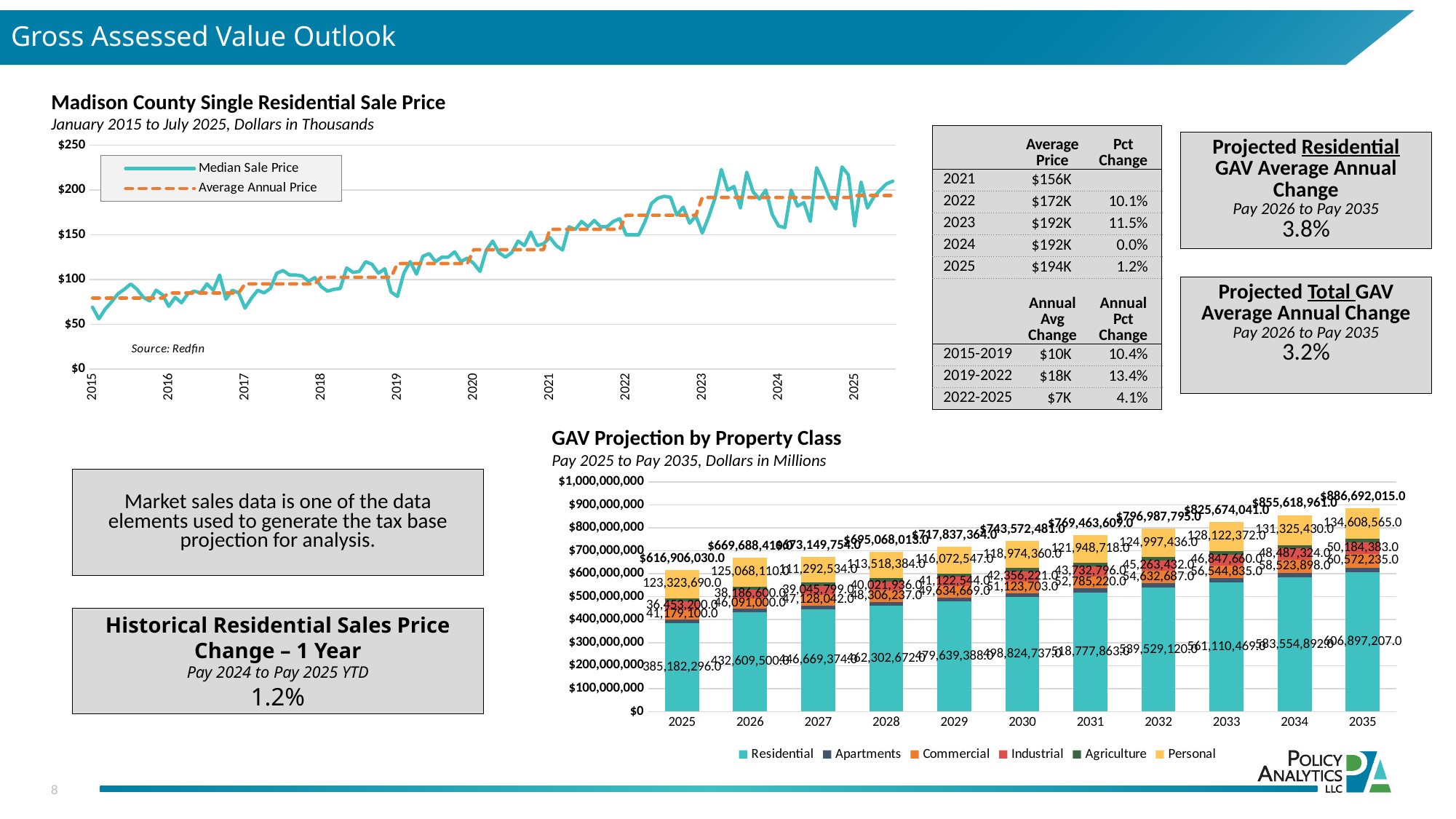
In the 'GAV Projection by Property Class' chart, what is the total GAV for 2025? $616,906,030.0 In the 'GAV Projection by Property Class' chart, what is the Residential value for 2035? 606,897,207.0 In the 'Madison County Single Residential Sale Price' chart, do the values generally rise or fall from 2015 to 2025? rise In the 'Madison County Single Residential Sale Price' chart, is the Average Annual Price at the start of 2015 greater or less than $100? less How many series does the legend of the 'Madison County Single Residential Sale Price' chart list? 2 What kind of chart is the 'GAV Projection by Property Class' chart? stacked bar chart In the 'GAV Projection by Property Class' chart, what is the difference between the total GAV for 2035 ($886,692,015.0) and for 2025 ($616,906,030.0)? $269,785,985.0 In the 'GAV Projection by Property Class' chart, which year has the highest total GAV? 2035 In the 'Madison County Single Residential Sale Price' chart, is the Average Annual Price in 2024 greater or less than $150? greater What kind of chart is the 'Madison County Single Residential Sale Price' chart? line chart How many series does the legend of the 'GAV Projection by Property Class' chart list? 6 How many years are shown on the x axis of the 'GAV Projection by Property Class' chart? 11